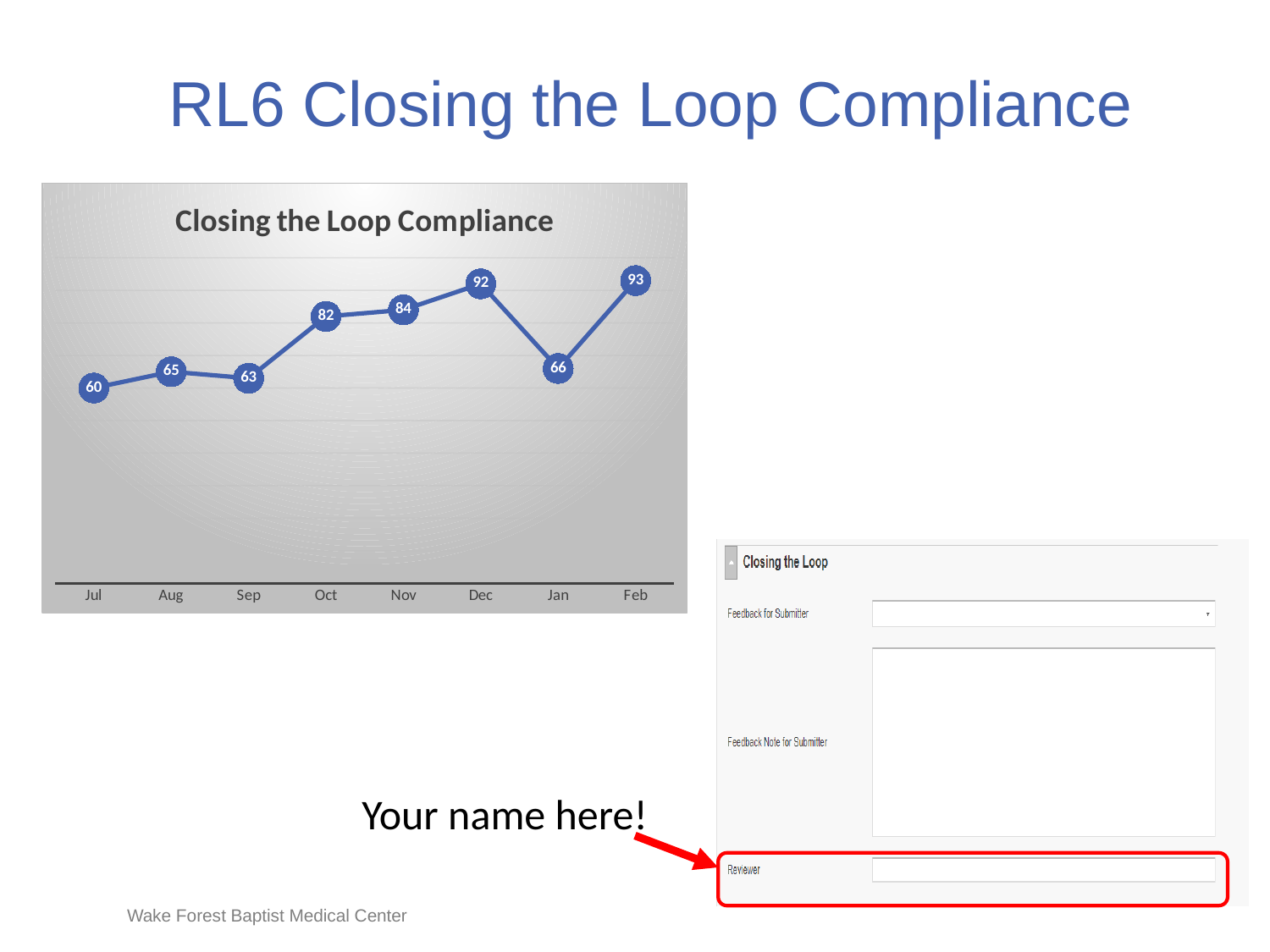
What is the value for Jan? 66 What kind of chart is shown? line chart What is the difference between the values for Feb and Jul? 33 Which is larger, the value for Aug or the value for Sep? Aug Which month has the lowest value? Jul Does the value rise or fall from Dec to Jan? fall How many months are plotted on the chart? 8 What is the value for Oct? 82 What is the title of the chart? Closing the Loop Compliance What is the difference between the values for Dec and Jan? 26 What is the value for Jul? 60 Which month has the highest value? Feb